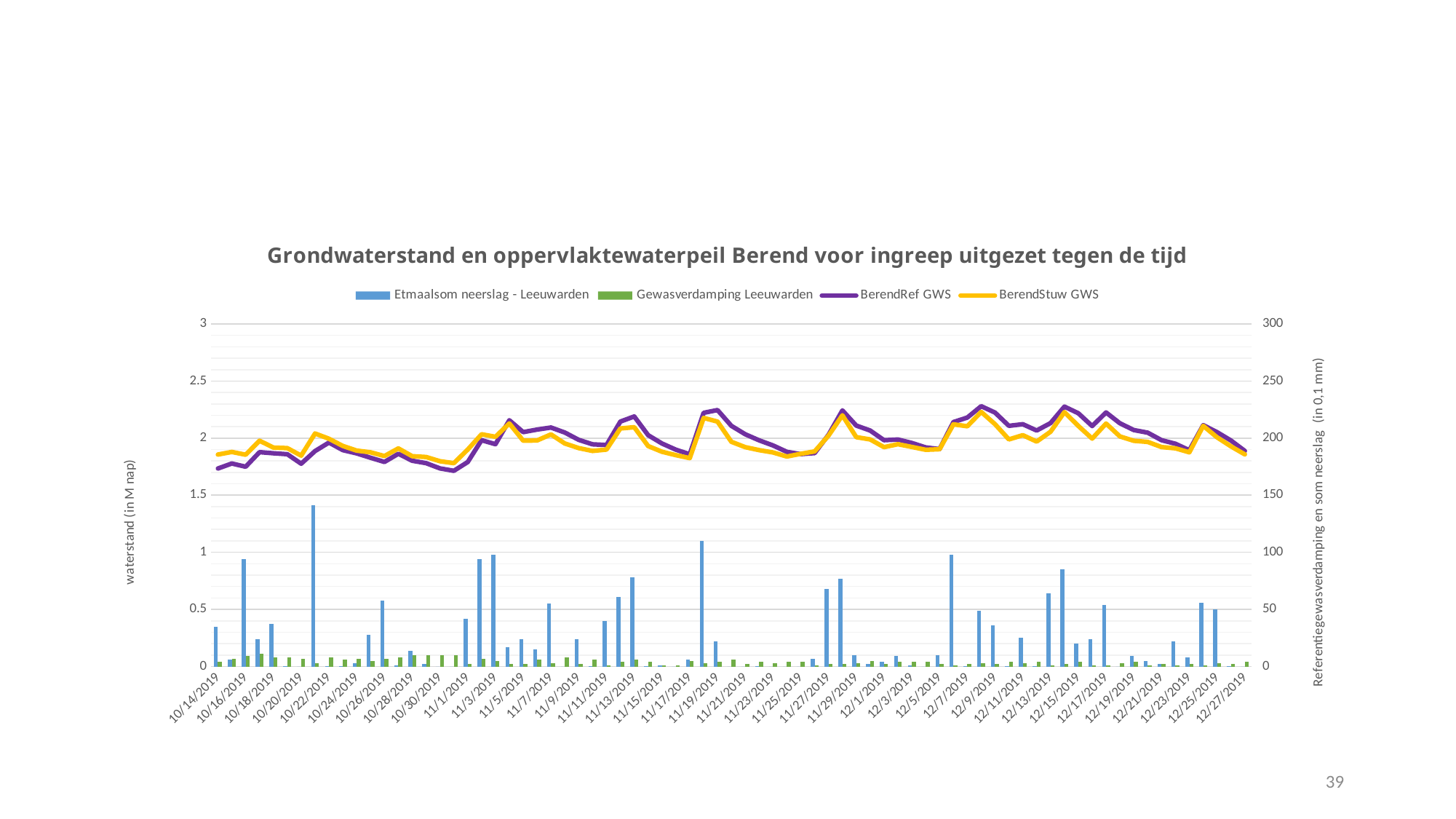
On 10/14/2019, which is higher: BerendRef GWS or BerendStuw GWS? BerendStuw GWS Is the BerendRef GWS value on 12/7/2019 greater or less than 2 on the left axis? greater What kind of chart is this? Combination bar and line chart On which date is the tallest Etmaalsom neerslag - Leeuwarden bar? 10/21/2019 Does the BerendRef GWS line rise or fall between 12/15/2019 and 12/27/2019? fall How many series does the chart's legend list? 4 Is the Etmaalsom neerslag - Leeuwarden bar on 10/22/2019 greater or less than 100 on the right axis? less Which series is drawn as a purple line? BerendRef GWS Does the BerendRef GWS line ever rise above 2.5 on the left axis? No What is the title of the chart? Grondwaterstand en oppervlaktewaterpeil Berend voor ingreep uitgezet tegen de tijd